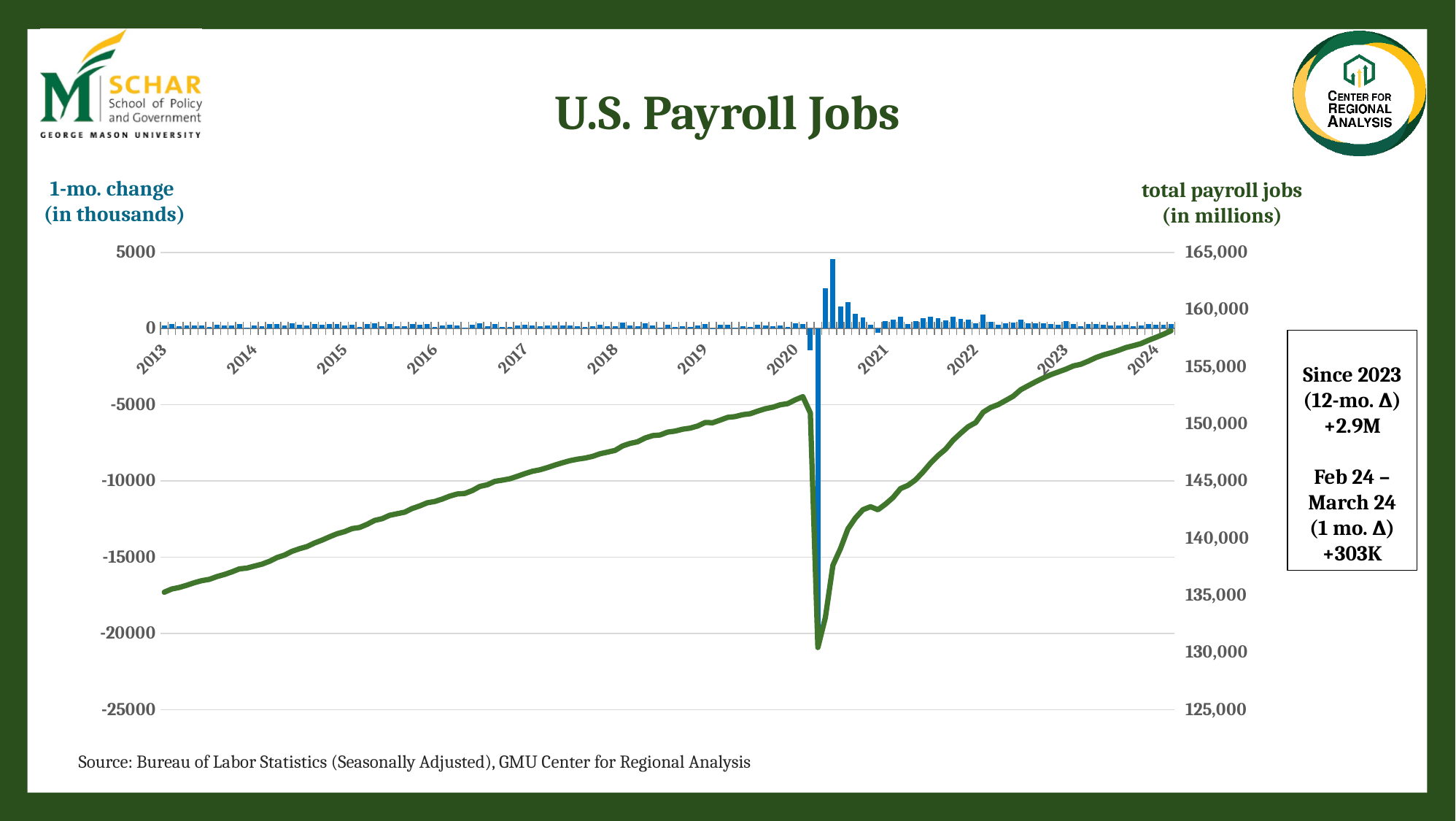
Does the total payroll jobs line rise or fall between 2013 and the start of 2020? rise Is the lowest point of the total payroll jobs line in 2020 greater or less than 135,000? less Is the largest positive 1-month change bar in 2020 greater or less than 2500? greater In which year does the line for total payroll jobs reach its lowest point? 2020 What does the left axis of the chart measure? 1-mo. change (in thousands) What kind of chart is shown on the slide? A combined bar and line chart In which year does the largest negative 1-month change bar occur? 2020 What is the title of the chart on the slide? U.S. Payroll Jobs According to the text box on the slide, what is the 12-month change in payroll jobs since 2023? +2.9M Is the total payroll jobs value at the end of the line in 2024 greater or less than 155,000? greater According to the text box on the slide, what is the 1-month change in payroll jobs from Feb 24 to March 24? +303K